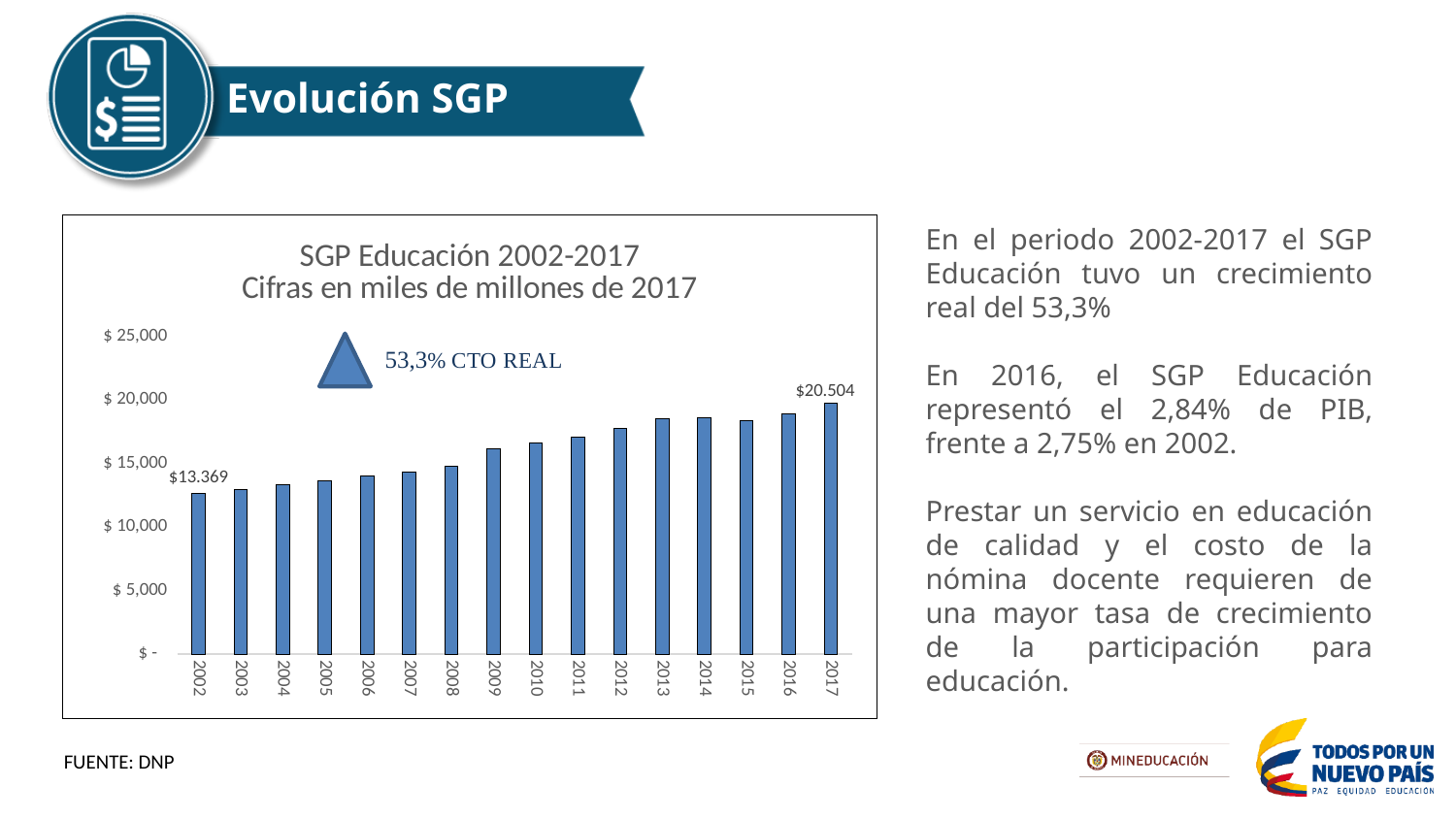
How many years are plotted in the SGP Educación 2002-2017 chart? 16 Which year has the highest value in the SGP Educación 2002-2017 chart? 2017 Which year has the lowest value in the SGP Educación 2002-2017 chart? 2002 Do the values in the SGP Educación chart generally rise or fall from 2002 to 2017? Rise What is the value for 2002 in the SGP Educación 2002-2017 chart? $13.369 What is the difference between the 2017 and 2002 values in the SGP Educación chart? $7.135 What kind of chart is the SGP Educación 2002-2017 chart? Bar chart Is the value for 2010 in the SGP Educación chart greater or less than $ 15,000? greater What is the value for 2017 in the SGP Educación 2002-2017 chart? $20.504 Is the value for 2005 in the SGP Educación chart greater or less than $ 15,000? less What real growth percentage is annotated on the SGP Educación 2002-2017 chart? 53,3% CTO REAL Which is larger in the SGP Educación chart, the value for 2017 or the value for 2002? 2017